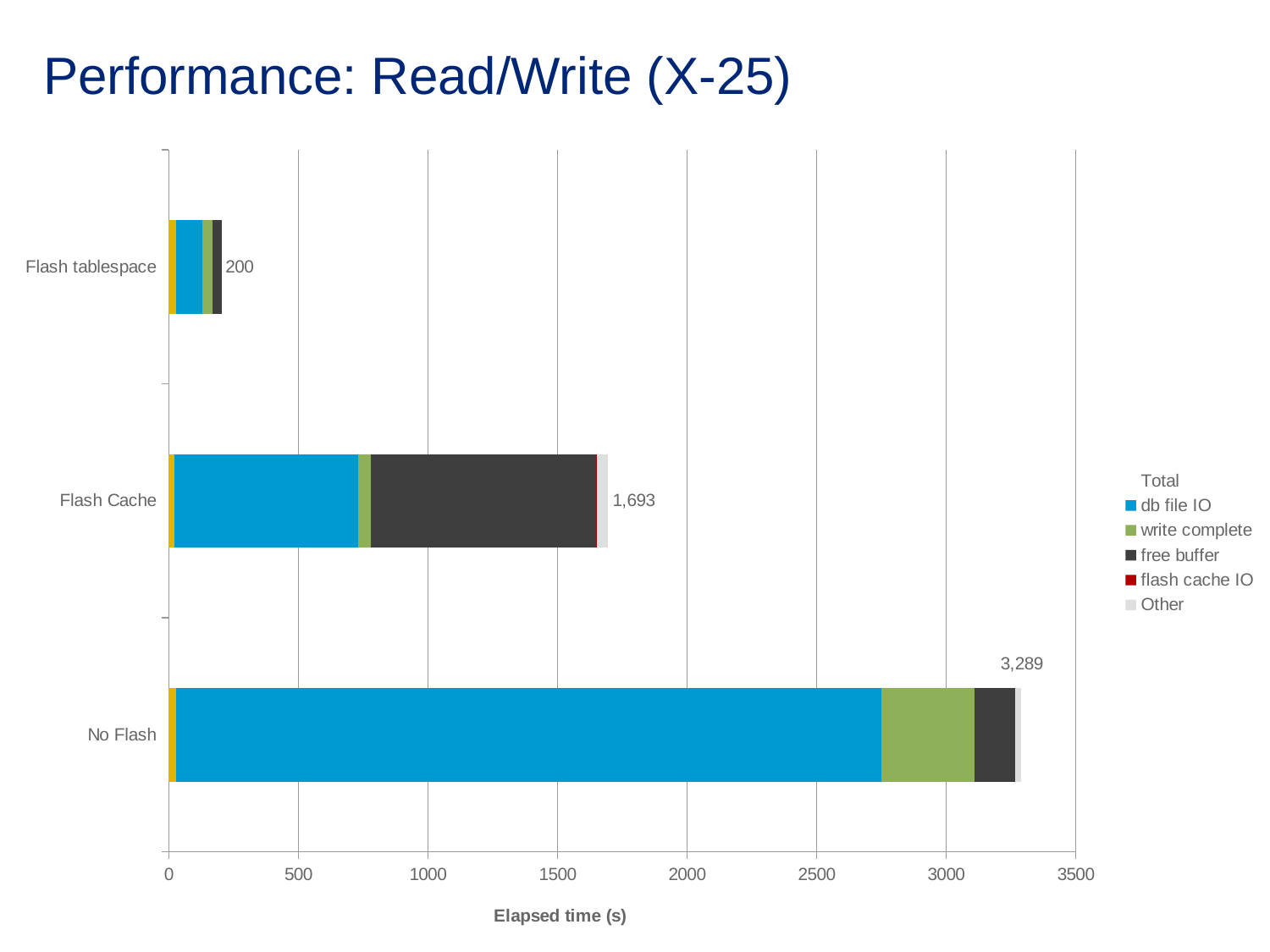
How many categories are shown on the vertical axis? 3 Which category has the lowest total elapsed time? Flash tablespace What is the total elapsed time labelled for the Flash Cache bar? 1,693 What is the label of the horizontal axis? Elapsed time (s) Which has a larger total elapsed time, Flash Cache or Flash tablespace? Flash Cache What is the difference between the labelled totals for Flash Cache and Flash tablespace? 1,493 What is the total elapsed time labelled for the Flash tablespace bar? 200 Which category has the highest total elapsed time? No Flash What kind of chart is shown on the slide? Stacked horizontal bar chart What is the total elapsed time labelled for the No Flash bar? 3,289 Is the db file IO segment for No Flash greater or less than 2500? greater What is the difference between the labelled totals for No Flash and Flash Cache? 1,596